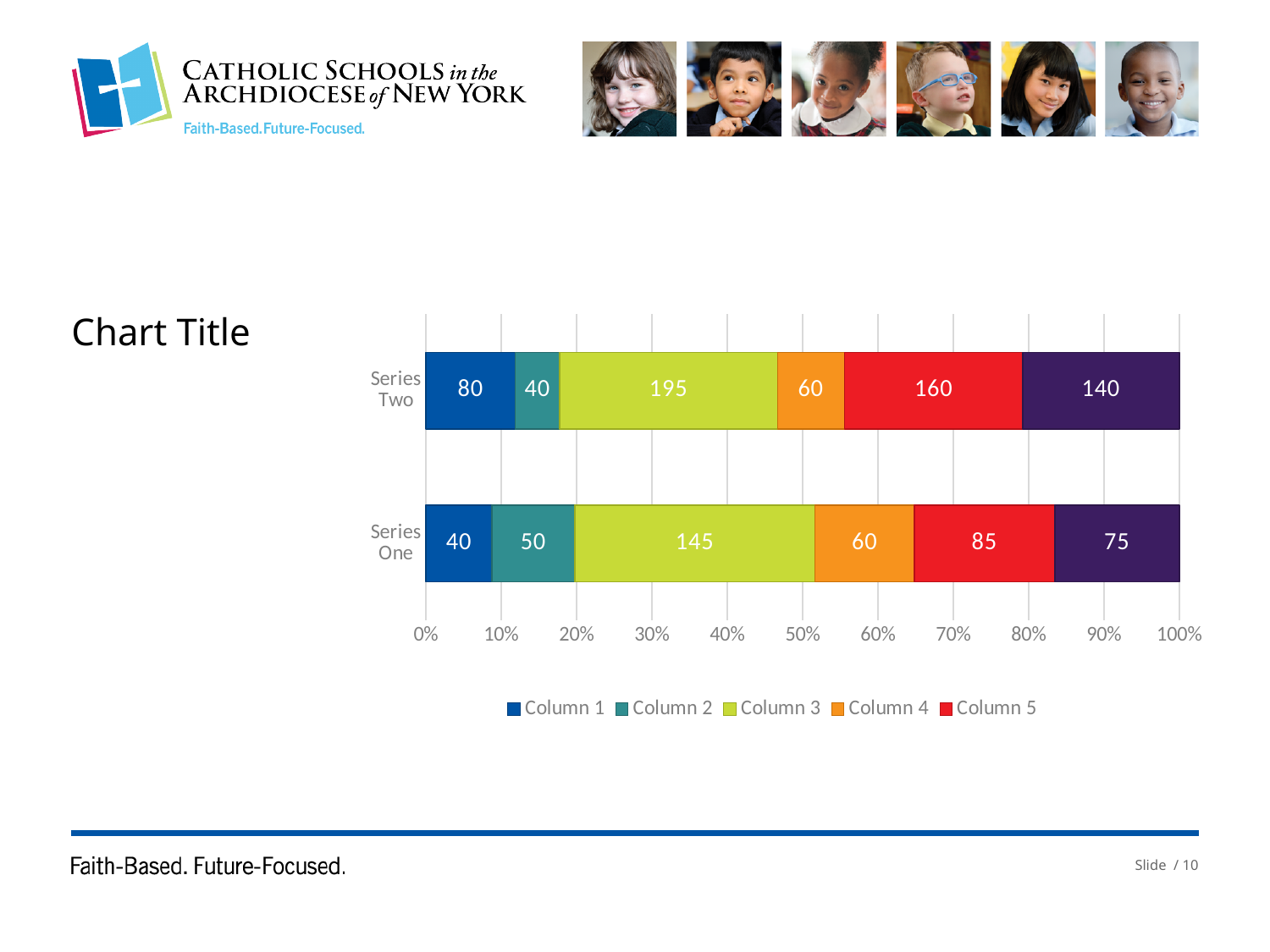
What is the total of all segments in the Series One bar? 455 Which column has the largest value in the Series One bar? Column 3 How much larger is Column 5 for Series Two than for Series One? 75 What kind of chart is shown on the slide? bar chart What is the value of Column 5 for Series One? 85 How many entries does the chart legend list? 5 How many bars (series categories) are shown on the chart? 2 Which series has the larger value for Column 1, Series One or Series Two? Series Two What is the value of Column 3 for Series Two? 195 What is the difference between the Column 3 values of Series Two and Series One? 50 What is the value of Column 1 for Series Two? 80 Which column has the smallest value in the Series Two bar? Column 2